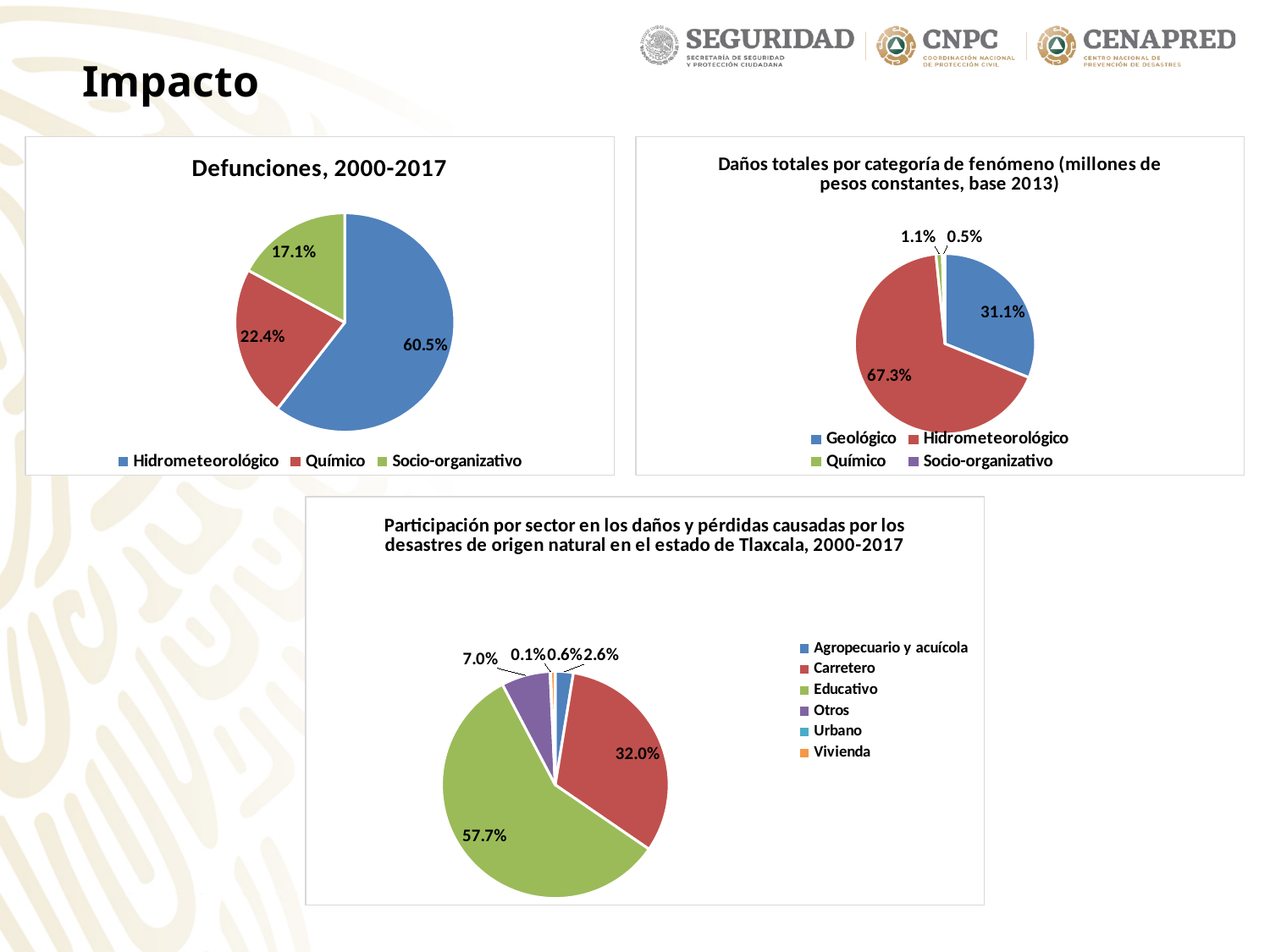
In the 'Defunciones, 2000-2017' chart, what percentage corresponds to Químico? 22.4% In the 'Defunciones, 2000-2017' chart, what is the difference in percentage points between Hidrometeorológico and Químico? 38.1 How many categories does the legend of the 'Daños totales por categoría de fenómeno' chart list? 4 In the 'Participación por sector' chart, which sector has the smallest share? Urbano In the 'Participación por sector' chart, what percentage corresponds to Educativo? 57.7% In the 'Defunciones, 2000-2017' chart, what share of deaths is attributed to Hidrometeorológico? 60.5% In the 'Daños totales por categoría de fenómeno' chart, what percentage corresponds to Hidrometeorológico? 67.3% In the 'Defunciones, 2000-2017' chart, which category has the smallest slice? Socio-organizativo In the 'Participación por sector' chart, which is larger, Carretero or Otros? Carretero What type of chart is used for 'Participación por sector en los daños y pérdidas'? Pie chart In the 'Daños totales por categoría de fenómeno' chart, which category has the largest share? Hidrometeorológico In the 'Daños totales por categoría de fenómeno' chart, what percentage corresponds to Socio-organizativo? 0.5%